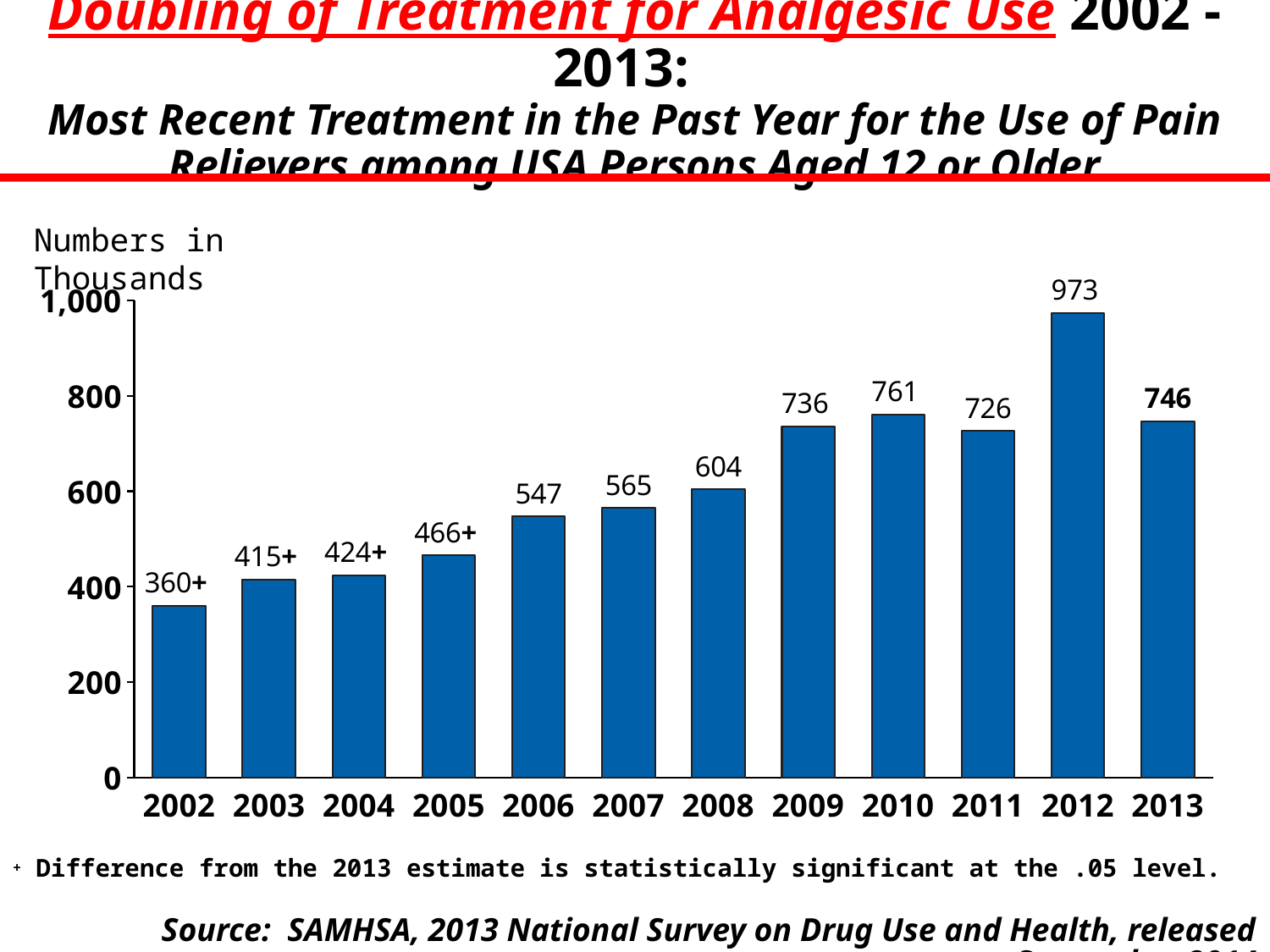
What is the difference between the values for 2012 and 2013? 227 Do the values generally rise or fall from 2002 to 2012? rise How many years are shown on the x axis? 12 What kind of chart is shown on the slide? bar chart What is the value for 2002? 360 Is the value for 2008 greater or less than 600? greater In what units are the values on the chart expressed? Numbers in Thousands Which is larger, the value for 2010 or the value for 2011? 2010 Which year has the highest value? 2012 What is the value for 2012? 973 Which year has the lowest value? 2002 What is the value for 2013? 746